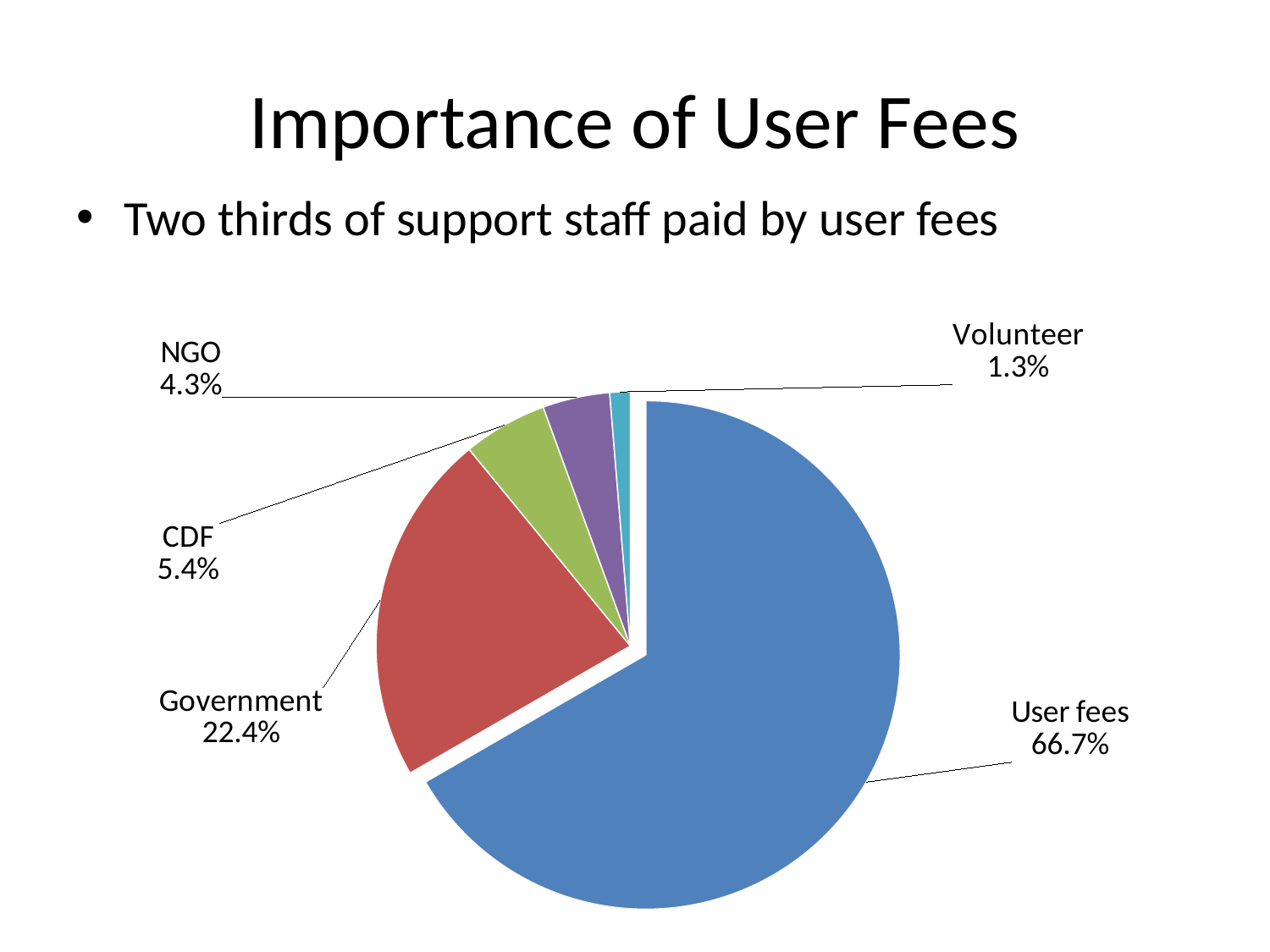
What kind of chart is shown on the slide? Pie chart Which is larger, the CDF slice or the NGO slice? CDF What share of the pie is NGO? 4.3% What share of the pie is Volunteer? 1.3% How many slices does the pie chart have? 5 What share of the pie is User fees? 66.7% What is the difference in percentage points between User fees and Government? 44.3 Which category has the largest slice of the pie? User fees What is the title of the slide containing the chart? Importance of User Fees Which category has the smallest slice of the pie? Volunteer